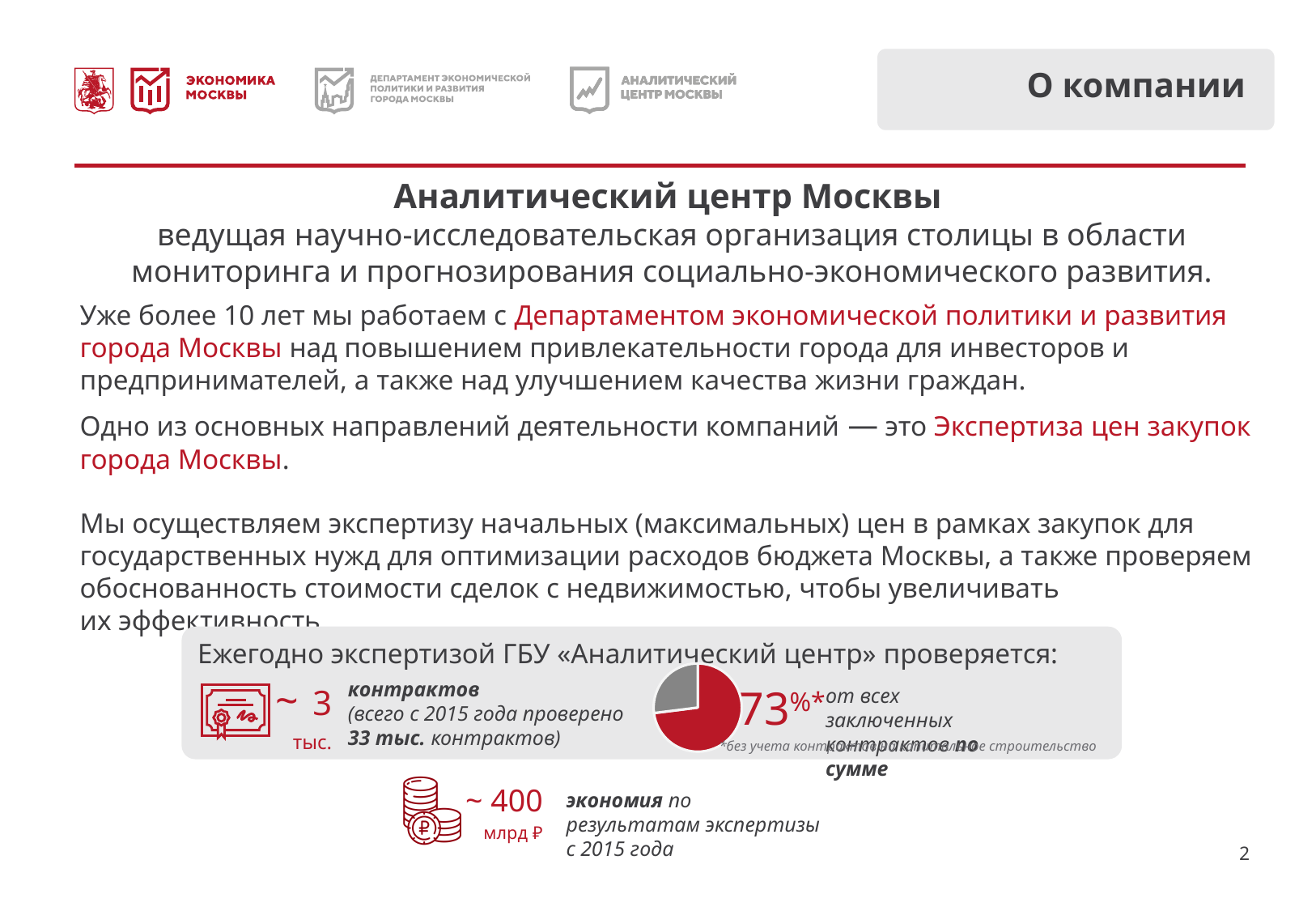
What share of the pie chart does the red slice represent? 73% Is the grey slice of the pie chart greater or less than 50%? less What value label is printed next to the pie chart? 73%* What colour is the largest slice of the pie chart? red Which slice of the pie chart is larger, the red one or the grey one? the red one How many slices does the pie chart have? 2 What share of the pie chart does the grey slice represent, given the red slice is 73%? 27% What kind of chart is shown on the slide next to the "73%" figure? pie chart Is the red slice of the pie chart greater or less than 50%? greater